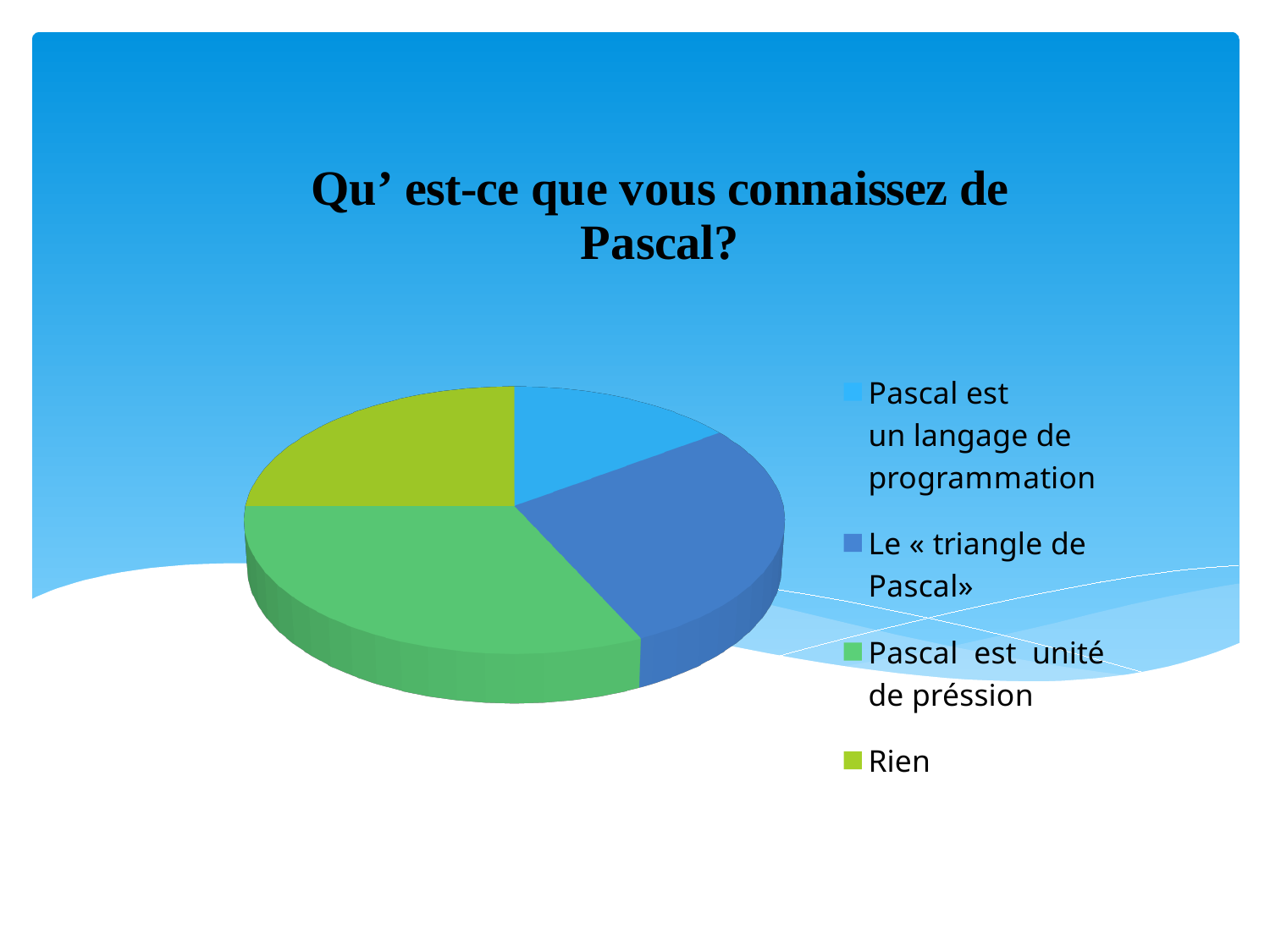
Which slice is larger: "Pascal est unité de préssion" or "Pascal est un langage de programmation"? Pascal est unité de préssion What colour is the slice for "Rien" in the pie chart? yellow-green How many entries does the legend of the pie chart list? 4 What is the title of the chart on the slide? Qu' est-ce que vous connaissez de Pascal? Which category has the largest slice of the pie chart? Pascal est unité de préssion Which slice is larger: "Pascal est unité de préssion" or "Rien"? Pascal est unité de préssion What kind of chart is shown on the slide? pie chart How many slices does the pie chart have? 4 Which category has the smallest slice of the pie chart? Pascal est un langage de programmation Which slice is larger: "Le « triangle de Pascal»" or "Pascal est un langage de programmation"? Le « triangle de Pascal»